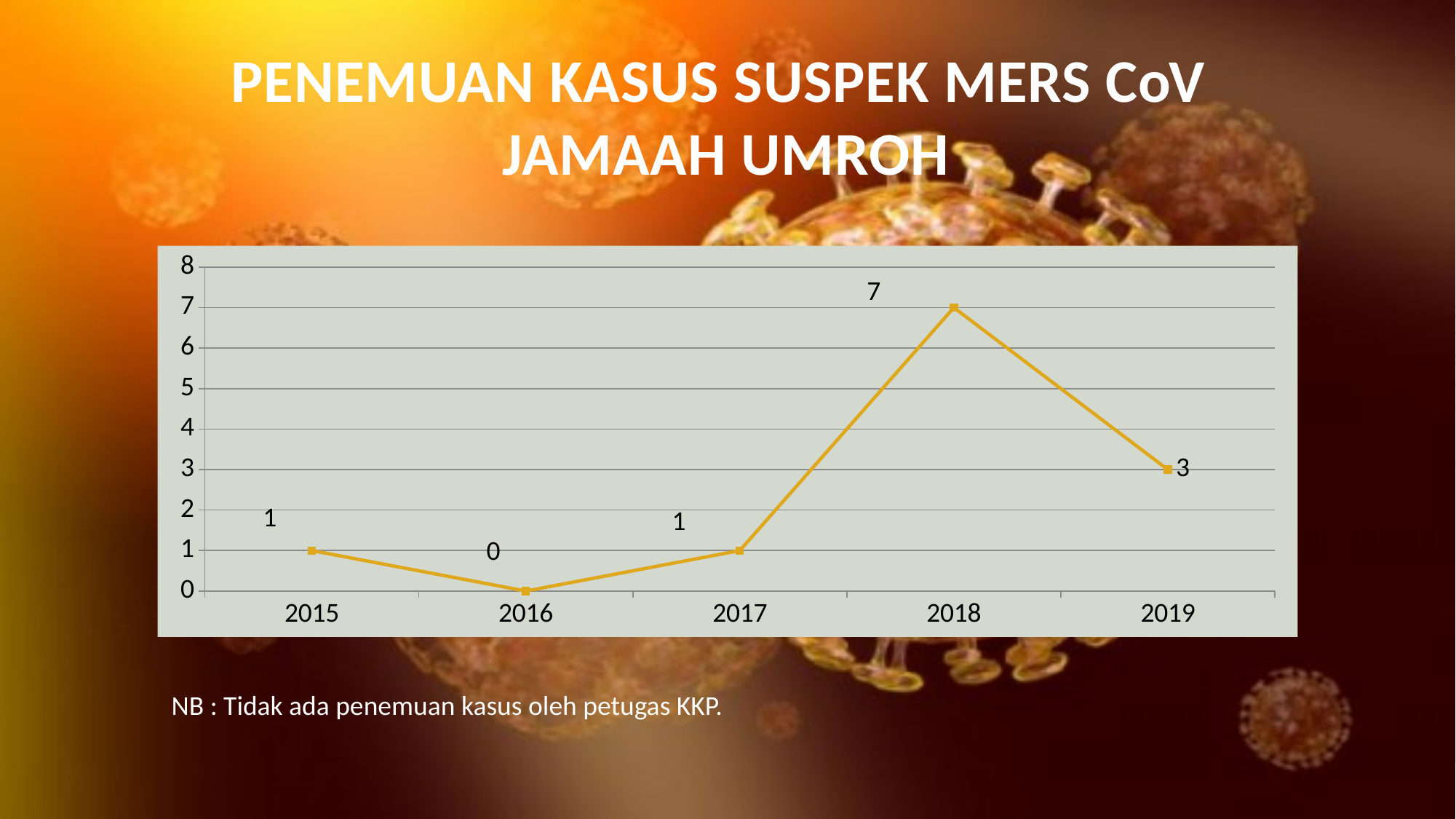
What is the value for 2016? 0 What is the value for 2019? 3 Which is larger, the value for 2017 or the value for 2019? 2019 What is the title of the slide? PENEMUAN KASUS SUSPEK MERS CoV JAMAAH UMROH Does the value rise or fall from 2018 to 2019? fall Which year has the highest value? 2018 Which year has the lowest value? 2016 What is the difference between the values for 2018 and 2019? 4 What is the value for 2018? 7 What kind of chart is shown? line chart How many years are plotted on the x axis? 5 What is the value for 2015? 1